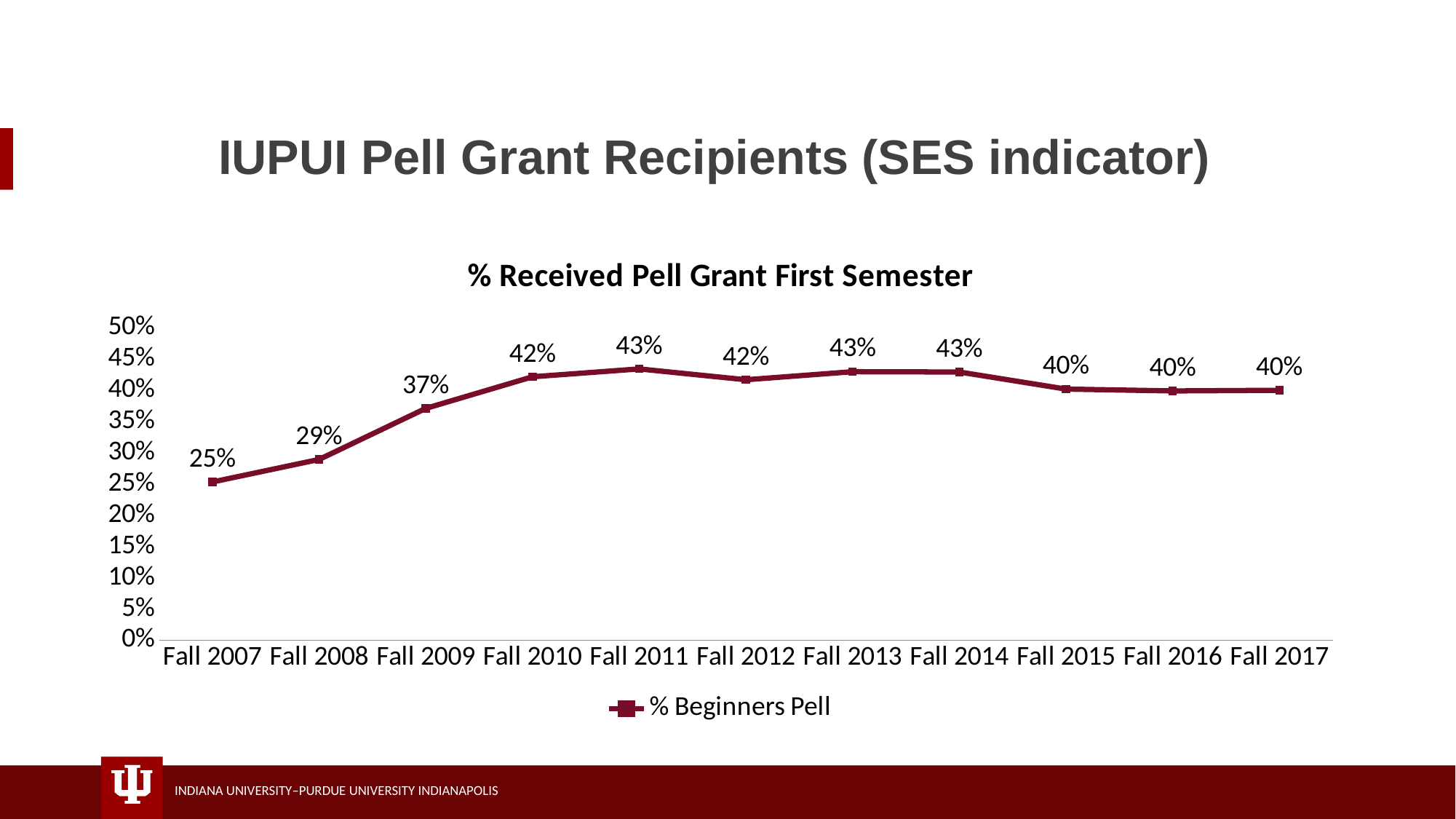
What is the value for Fall 2017? 40% Which category has the lowest value? Fall 2007 What is the value for Fall 2009? 37% How many categories are shown on the x axis? 11 What is the title of the chart? % Received Pell Grant First Semester Is the value for Fall 2008 greater or less than 35%? less What kind of chart is this? line chart Which is larger, the value for Fall 2008 or the value for Fall 2010? Fall 2010 What is the difference between the values for Fall 2011 and Fall 2007? 18% How many series does the legend list? 1 What is the difference between the values for Fall 2014 and Fall 2015? 3% What is the value for Fall 2007? 25%